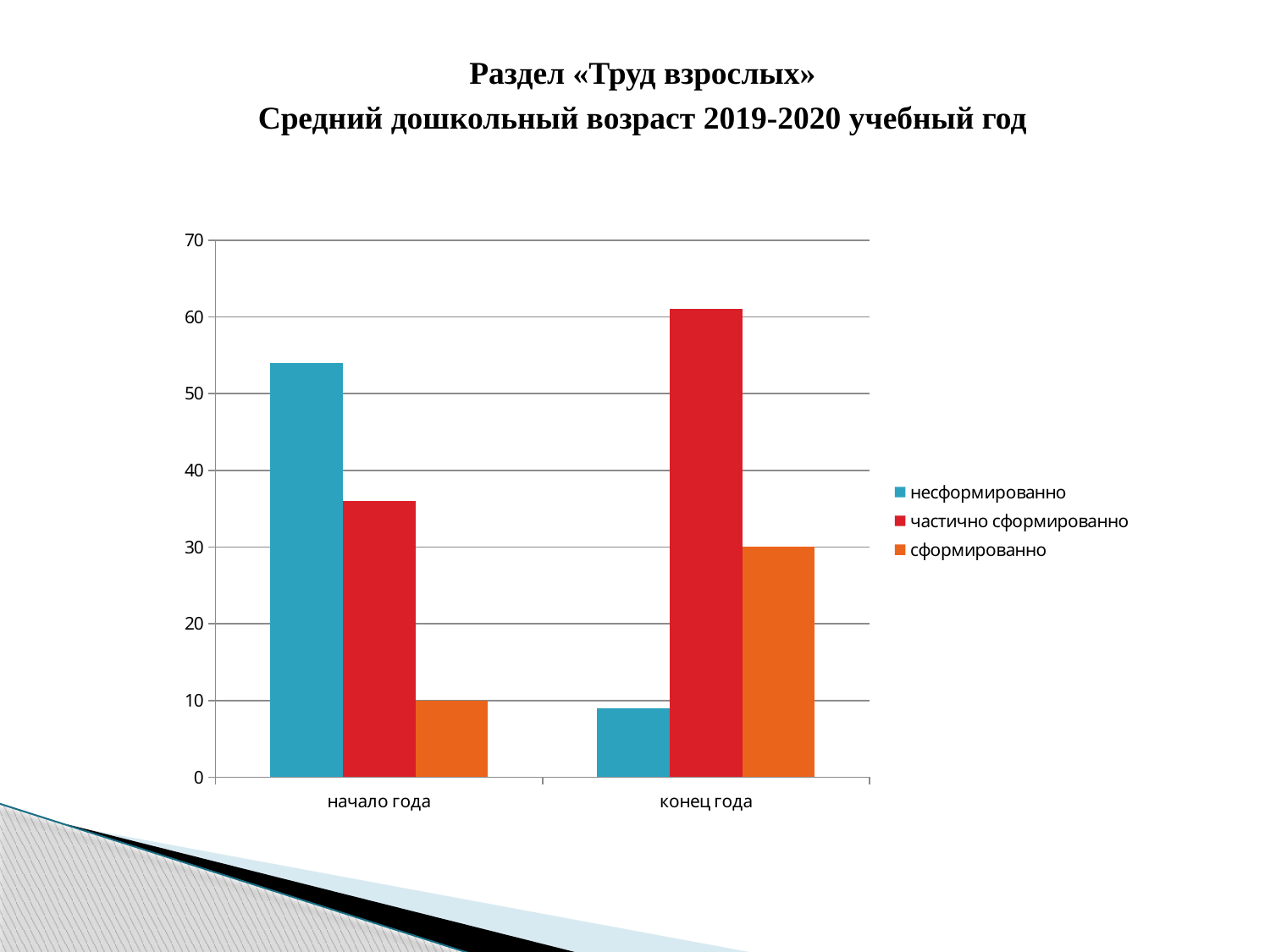
How many series does the legend list? 3 Is the value for частично сформированно at начало года greater or less than 40? less How many categories are shown on the x axis? 2 Is the value for частично сформированно at конец года greater or less than 50? greater Which series has the lowest bar for конец года? несформированно Is the value for несформированно at начало года greater or less than 50? greater Which series has the highest bar for начало года? несформированно Which series has the highest bar for конец года? частично сформированно Which is larger: сформированно at начало года or сформированно at конец года? конец года What type of chart is shown on the slide? bar chart Does the value for несформированно rise or fall from начало года to конец года? fall